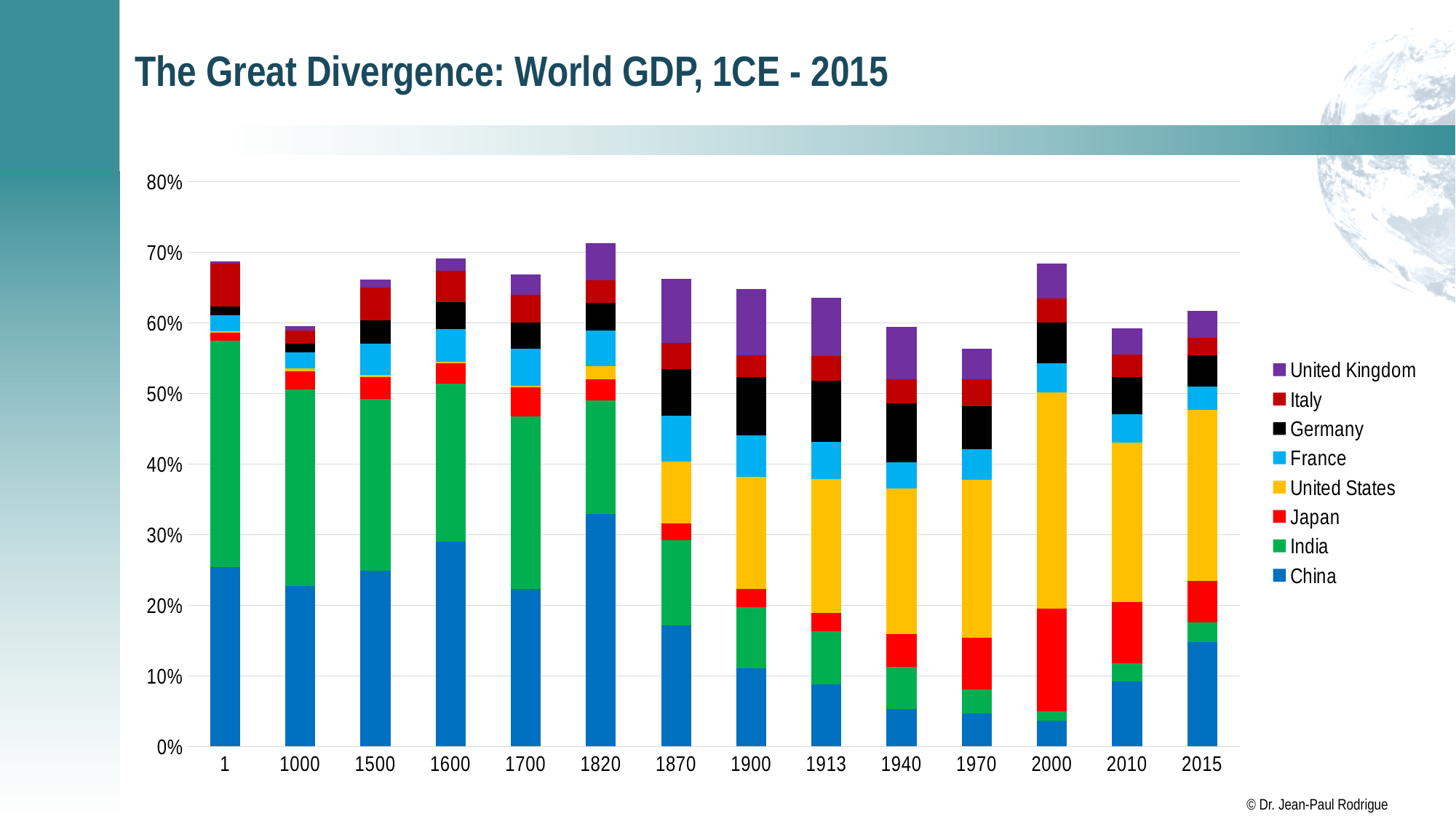
What kind of chart is shown on the slide? Stacked bar chart Does the China segment rise or fall from 1820 to 2000? Fall How many years (categories) are shown along the x axis? 14 Which series is plotted at the bottom of each stacked bar? China Which year has the shortest stacked bar? 1970 How many series does the legend list? 8 Which is larger, the China segment for year 1 or the China segment for 2015? Year 1 Which is larger, the India segment for 1500 or the India segment for 1900? 1500 Is the total of the stacked bar for 1970 greater or less than 60%? less Which year has the tallest stacked bar? 1820 Is the China segment for 1820 greater or less than 30%? greater Is the China segment for 2000 greater or less than 10%? less